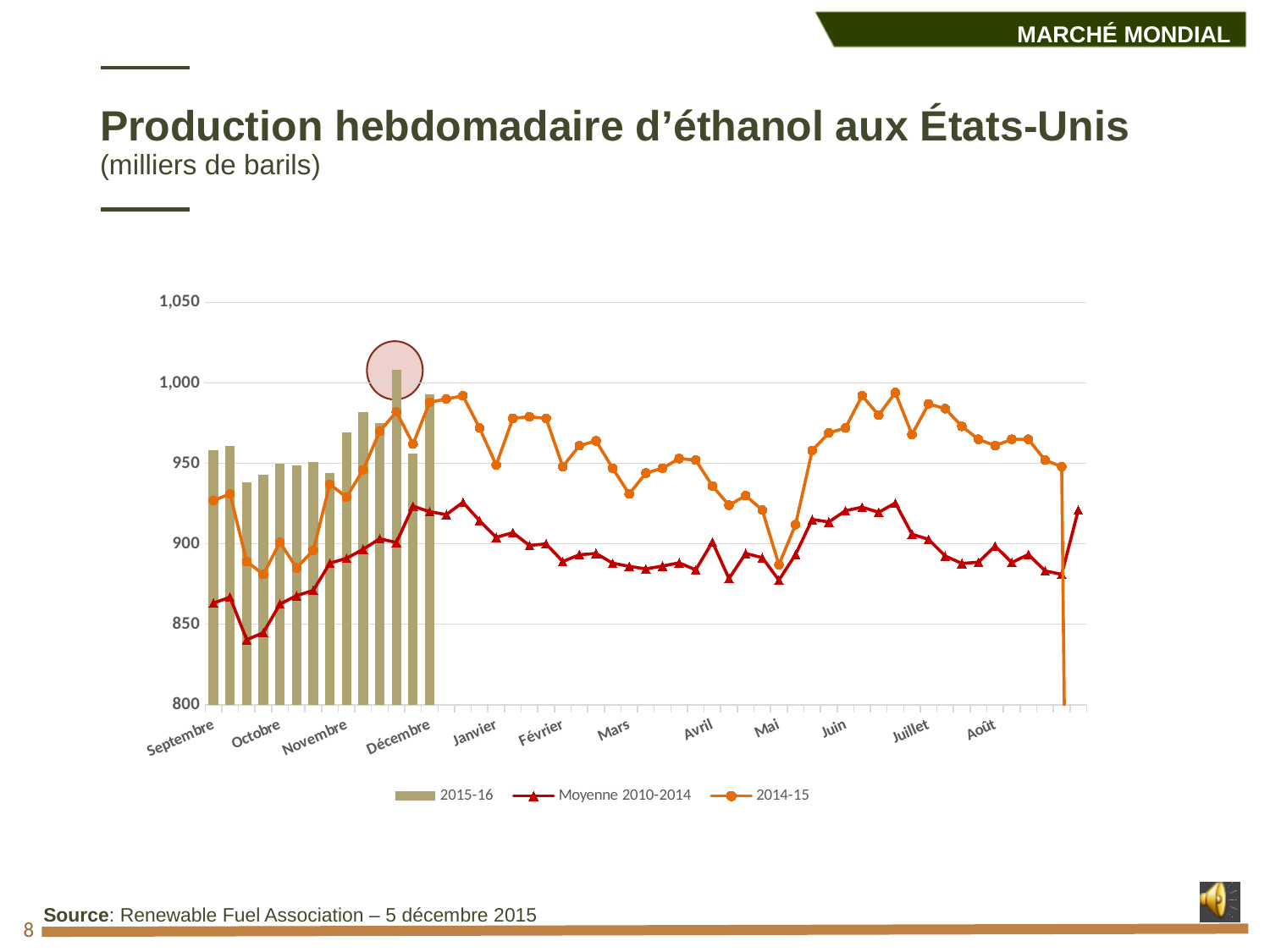
Is the value of the circled 2015-16 bar in Décembre greater or less than 1,000? greater How many series does the legend list? 3 Does the 2014-15 line rise or fall from Mai to Juin? rise Which series is drawn as bars? 2015-16 Does the Moyenne 2010-2014 line rise or fall from Janvier to Mars? fall Is the lowest value of the 2014-15 line in Octobre greater or less than 900? less What kind of chart is shown on the slide? A combination chart with bars and lines How many month labels are shown on the x axis? 12 Is the peak of the 2014-15 line in Juin greater or less than 950? greater In Septembre, which is higher: the 2014-15 line or the Moyenne 2010-2014 line? 2014-15 What is the title of the chart on the slide? Production hebdomadaire d'éthanol aux États-Unis